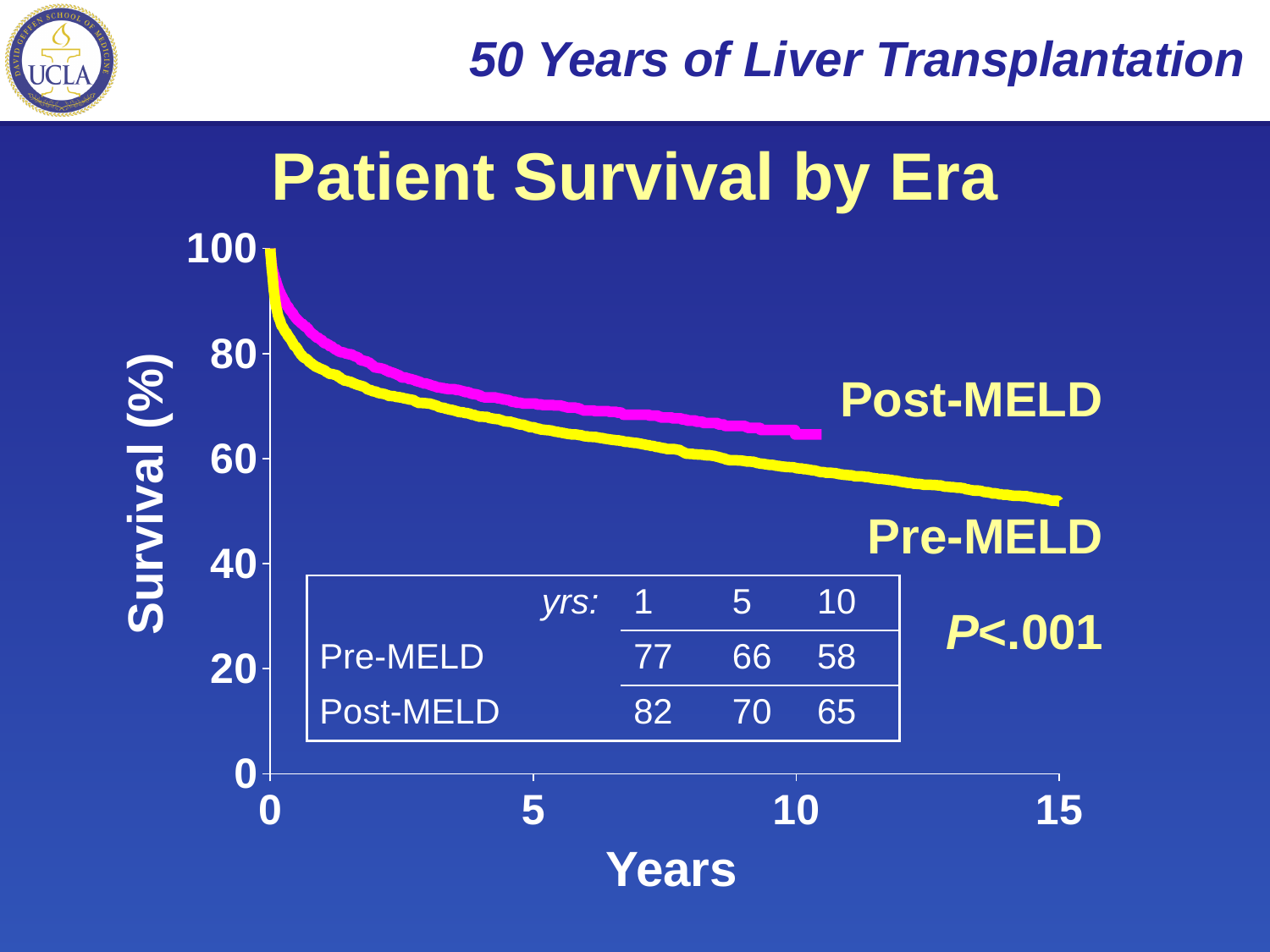
What is the 1-year survival for Post-MELD? 82 What is the label of the y axis? Survival (%) What is the difference between the 1-year and 10-year survival for Post-MELD? 17 What is the title of the chart? Patient Survival by Era Is the Pre-MELD survival at 15 years greater or less than 60? less What is the 5-year survival for Pre-MELD? 66 How many series (eras) are plotted on the chart? 2 What is the difference between Post-MELD and Pre-MELD survival at 10 years? 7 What type of chart is shown on the slide? line chart Which era has the higher 5-year survival, Pre-MELD or Post-MELD? Post-MELD Does survival rise or fall as years increase for both eras? fall What is the 10-year survival for Pre-MELD? 58